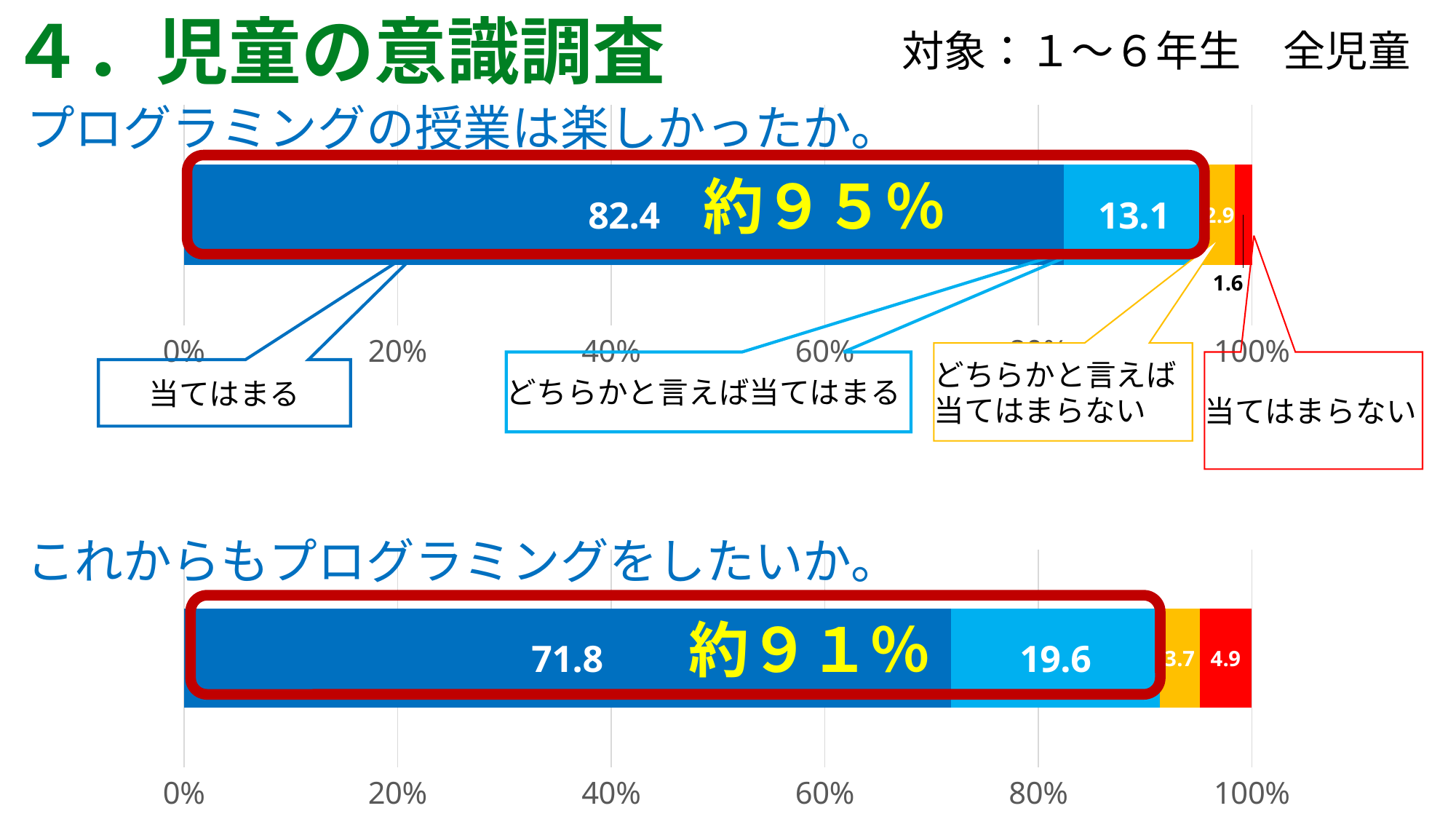
What kind of chart is used on this slide? Stacked horizontal bar chart In the top chart (プログラミングの授業は楽しかったか。), what is the value for どちらかと言えば当てはまる? 13.1 Which is larger: the value for 当てはまる in the top chart or the value for 当てはまる in the bottom chart? Top chart (82.4) In the bottom chart (これからもプログラミングをしたいか。), what is the value for どちらかと言えば当てはまる? 19.6 In the bottom chart (これからもプログラミングをしたいか。), what is the value for どちらかと言えば当てはまらない? 3.7 In the top chart (プログラミングの授業は楽しかったか。), which category has the largest value? 当てはまる In the top chart (プログラミングの授業は楽しかったか。), what is the value for 当てはまる? 82.4 In the bottom chart (これからもプログラミングをしたいか。), what is the difference between the values for 当てはまる and どちらかと言えば当てはまる? 52.2 In the bottom chart (これからもプログラミングをしたいか。), what is the value for 当てはまらない? 4.9 In the top chart (プログラミングの授業は楽しかったか。), what is the value for 当てはまらない? 1.6 In the bottom chart (これからもプログラミングをしたいか。), which category has the smallest value? どちらかと言えば当てはまらない In the bottom chart (これからもプログラミングをしたいか。), what is the value for 当てはまる? 71.8